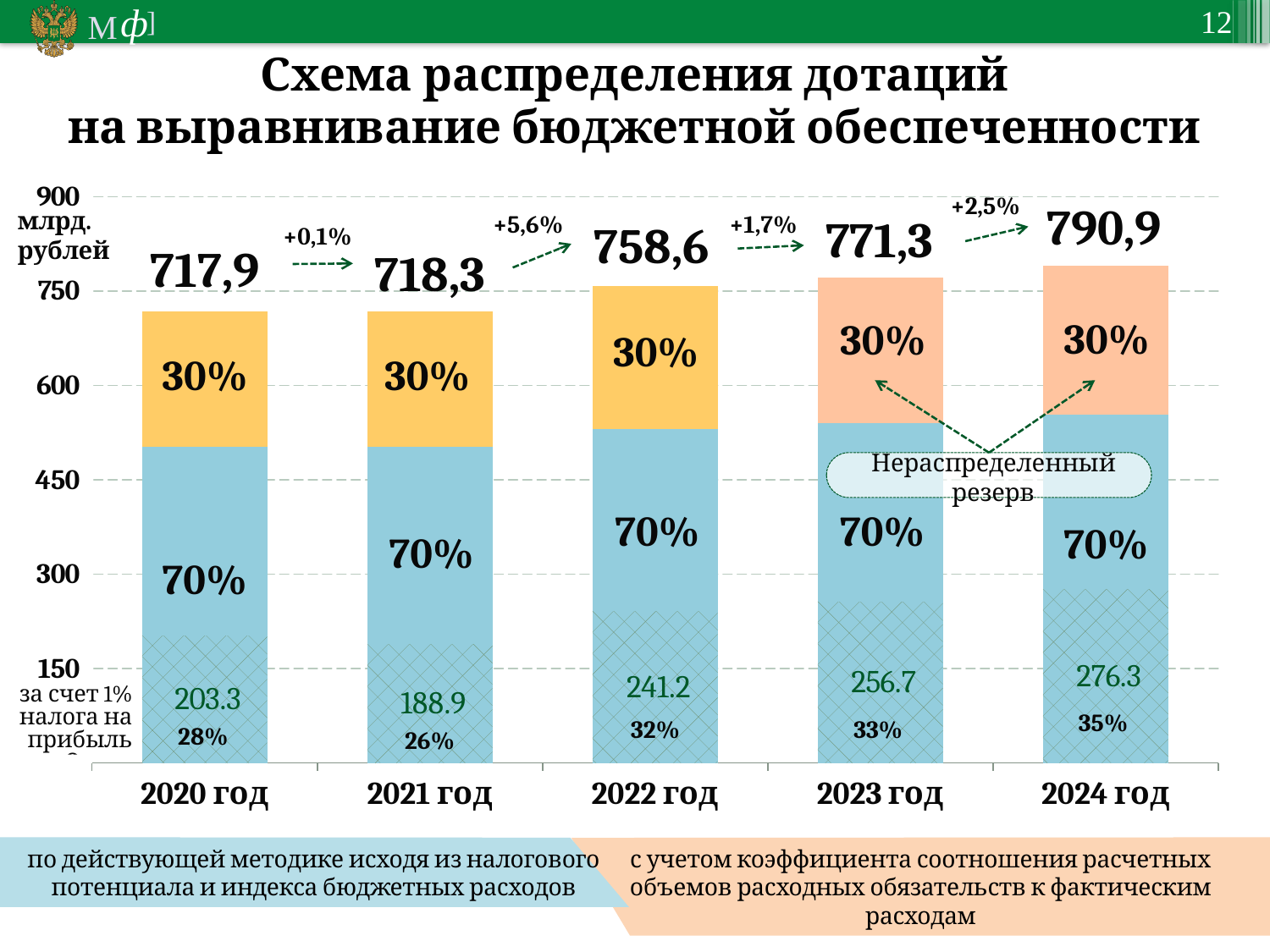
Which year has the lowest total value? 2020 год What is the total value shown above the bar for 2022 год? 758,6 Which is larger, the hatched value for 2020 год or for 2021 год? 2020 год What type of chart is shown on the slide? stacked bar chart What percentage growth is shown by the arrow between 2021 год and 2022 год? +5,6% How many years are shown on the x axis? 5 What is the total value shown above the bar for 2024 год? 790,9 What value is printed in the hatched lower portion of the 2021 год bar? 188.9 Do the total values rise or fall from 2020 год to 2024 год? rise What is the difference between the total for 2024 год and the total for 2020 год? 73,0 Which year has the highest total value? 2024 год What percentage is printed at the bottom of the 2023 год bar? 33%